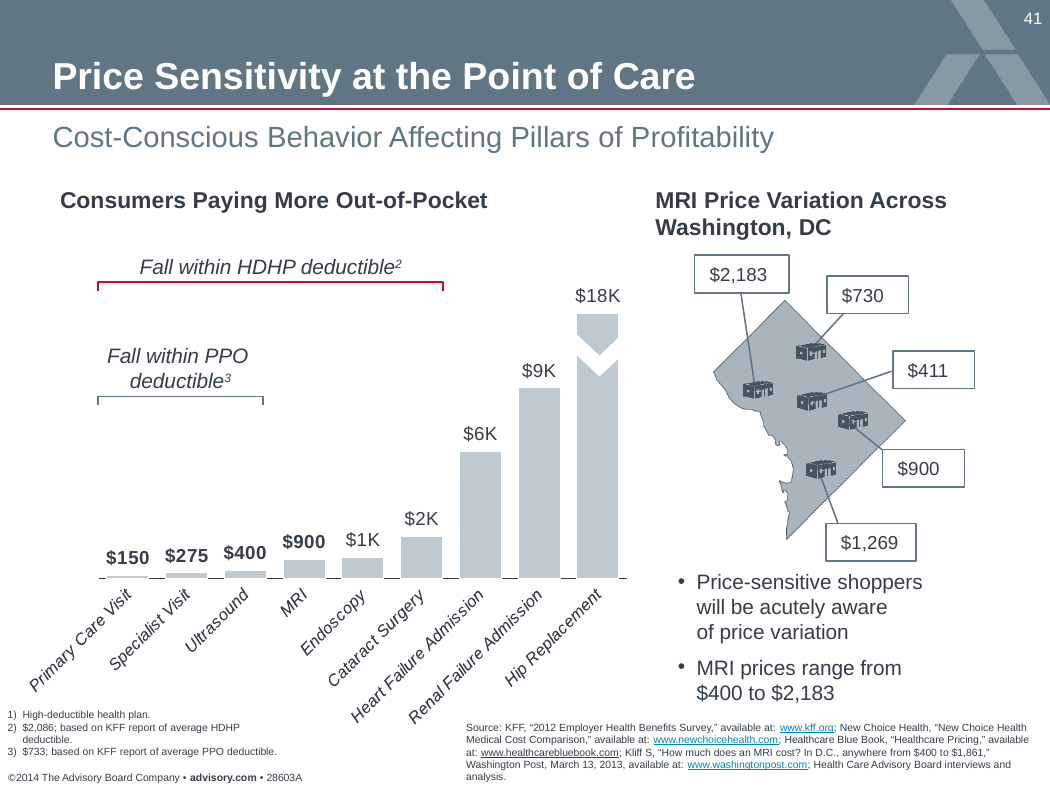
What is the value for Cataract Surgery in the Consumers Paying More Out-of-Pocket chart? $2K What is the value for Specialist Visit in the Consumers Paying More Out-of-Pocket chart? $275 Which category has the highest value in the Consumers Paying More Out-of-Pocket chart? Hip Replacement In the Consumers Paying More Out-of-Pocket chart, which is larger, Endoscopy or MRI? Endoscopy What kind of chart is the Consumers Paying More Out-of-Pocket chart? Bar chart Which category has the lowest value in the Consumers Paying More Out-of-Pocket chart? Primary Care Visit In the Consumers Paying More Out-of-Pocket chart, what is the difference between Renal Failure Admission and Heart Failure Admission? $3K In the Consumers Paying More Out-of-Pocket chart, what is the difference between Ultrasound and Primary Care Visit? $250 How many categories are shown in the Consumers Paying More Out-of-Pocket chart? 9 What is the value for Hip Replacement in the Consumers Paying More Out-of-Pocket chart? $18K What is the value for MRI in the Consumers Paying More Out-of-Pocket chart? $900 Do the values in the Consumers Paying More Out-of-Pocket chart rise or fall from left to right along the x axis? Rise